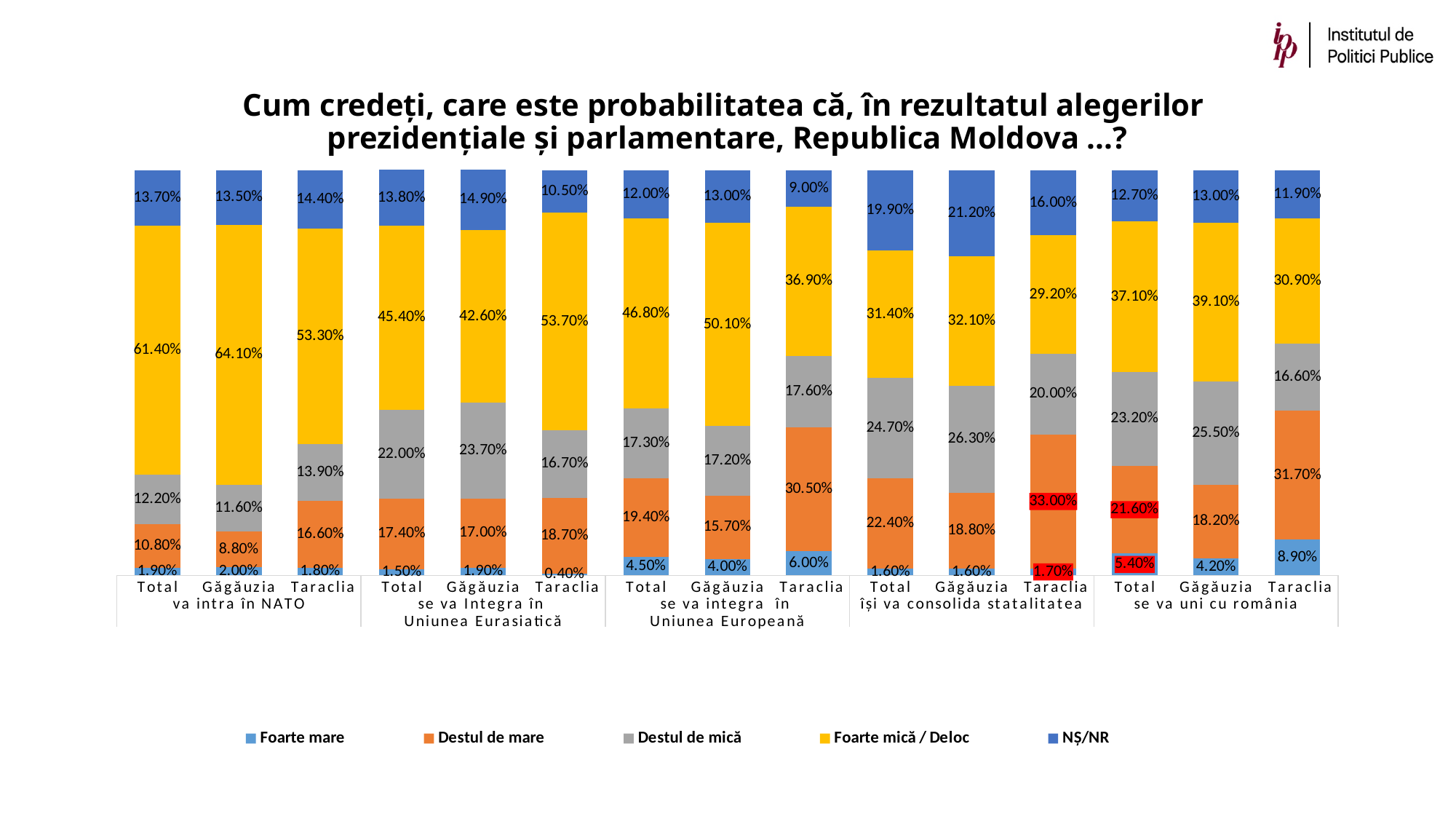
How many bars are plotted in the chart? 15 What kind of chart is shown on the slide? Stacked bar chart What percentage of Găgăuzia respondents answered "Foarte mică / Deloc" for "va intra în NATO"? 64.10% Which bar has the highest "Foarte mică / Deloc" value? Găgăuzia, va intra în NATO (64.10%) Which is larger: the "Destul de mare" value for Taraclia in "se va integra în Uniunea Europeană" or for Taraclia in "se va uni cu românia"? Taraclia, se va uni cu românia (31.70%) How many series does the legend list? 5 What is the "Foarte mare" value for Taraclia in the "se va uni cu românia" group? 8.90% Which bar has the lowest "Foarte mare" value? Taraclia, se va Integra în Uniunea Eurasiatică (0.40%) What is the NȘ/NR value for Găgăuzia in the "își va consolida statalitatea" group? 21.20% What is the difference between the "Foarte mică / Deloc" value for Total in "va intra în NATO" and for Total in "se va integra în Uniunea Europeană"? 14.60% What is the "Destul de mare" value for Taraclia in the "își va consolida statalitatea" group? 33.00% What is the "Destul de mică" value for Total in the "se va integra în Uniunea Europeană" group? 17.30%